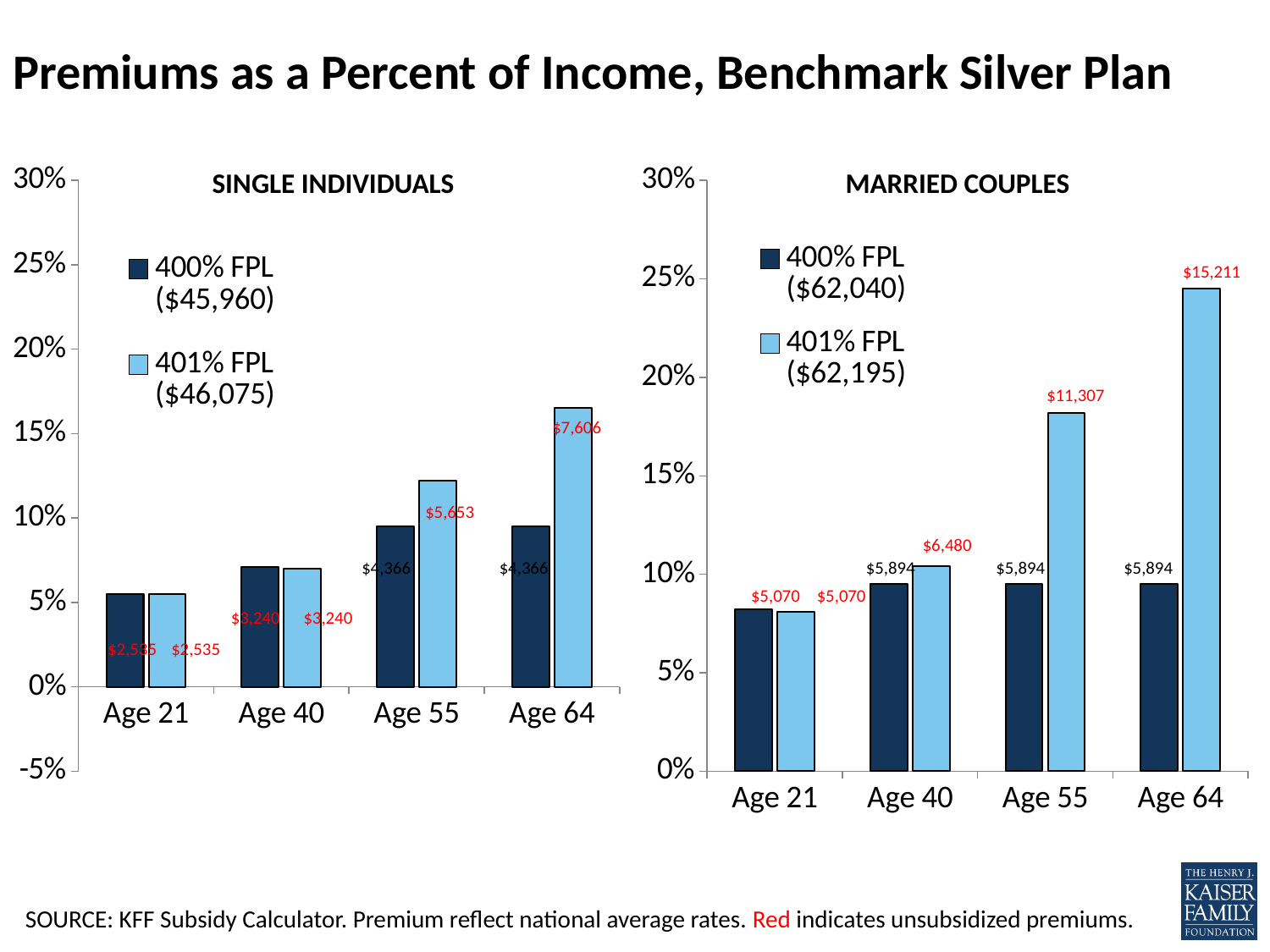
On the SINGLE INDIVIDUALS chart, is the 401% FPL value for Age 64 greater or less than 15%? greater On the MARRIED COUPLES chart, is the 400% FPL value for Age 21 greater or less than 10%? less What kind of chart is the SINGLE INDIVIDUALS chart? bar chart On the SINGLE INDIVIDUALS chart, what premium amount is labeled on the 401% FPL bar for Age 64? $7,606 On the MARRIED COUPLES chart, what premium amount is labeled on the 401% FPL bar for Age 55? $11,307 How many age categories are shown on the MARRIED COUPLES chart? 4 On the MARRIED COUPLES chart, what premium amount is labeled on the 400% FPL bar for Age 21? $5,070 According to the source note, what does red text indicate? unsubsidized premiums On the MARRIED COUPLES chart, what is the difference between the labeled premiums for the 401% FPL and 400% FPL bars at Age 64? $9,317 On the MARRIED COUPLES chart, do the 401% FPL values rise or fall as age increases? rise On the SINGLE INDIVIDUALS chart, which age and series has the highest premium as a percent of income? 401% FPL, Age 64 How many series does the legend of the SINGLE INDIVIDUALS chart list? 2